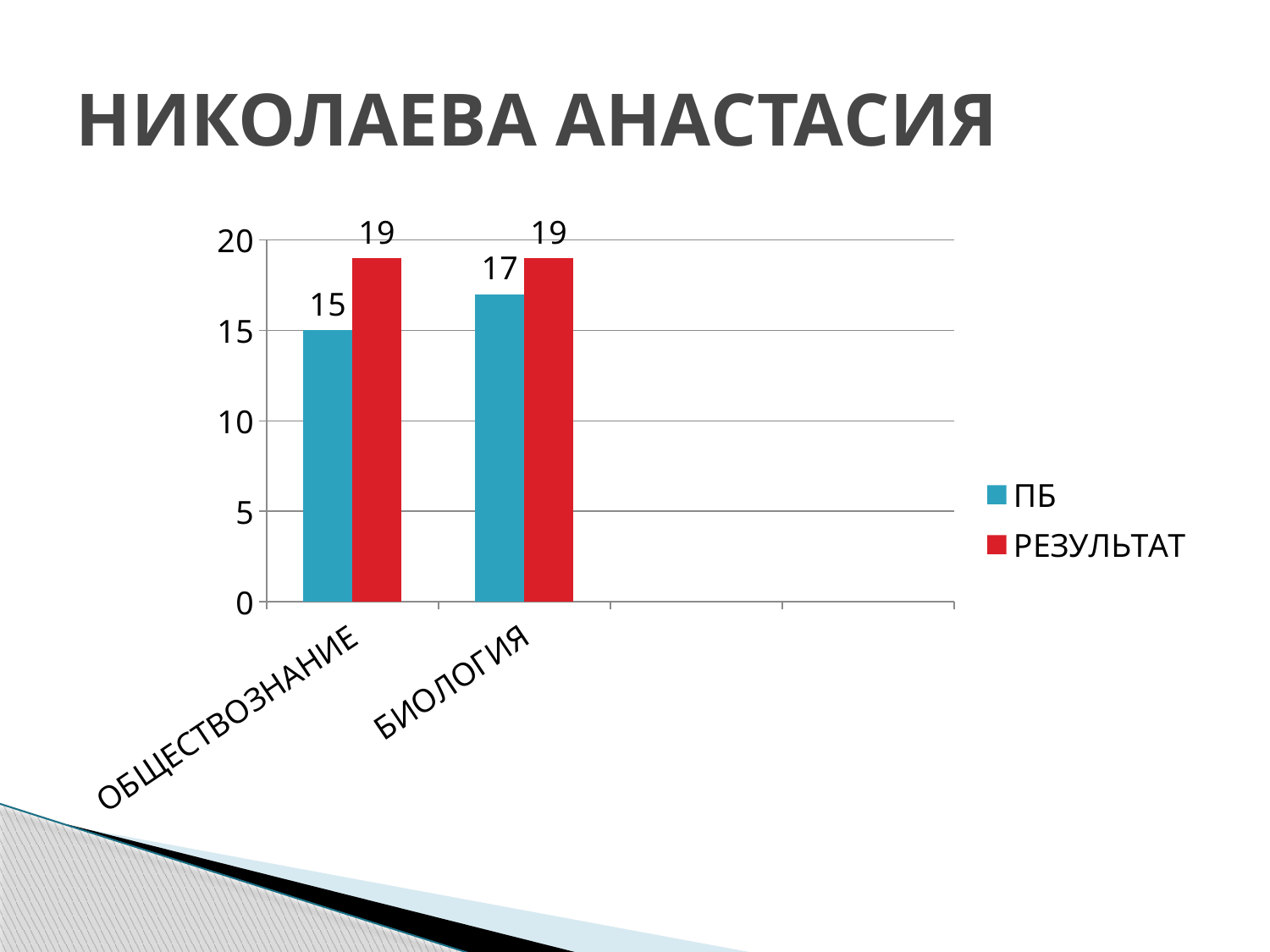
Which category has the lowest ПБ value? ОБЩЕСТВОЗНАНИЕ What is the difference between the РЕЗУЛЬТАТ and ПБ values for ОБЩЕСТВОЗНАНИЕ? 4 What colour are the РЕЗУЛЬТАТ bars? Red What is the ПБ value for БИОЛОГИЯ? 17 What is the difference between the РЕЗУЛЬТАТ and ПБ values for БИОЛОГИЯ? 2 What is the ПБ value for ОБЩЕСТВОЗНАНИЕ? 15 What kind of chart is shown on the slide? Bar chart Which is larger for БИОЛОГИЯ, the ПБ value or the РЕЗУЛЬТАТ value? РЕЗУЛЬТАТ What is the РЕЗУЛЬТАТ value for ОБЩЕСТВОЗНАНИЕ? 19 How many series does the legend list? 2 How many categories are shown on the x axis? 2 What is the РЕЗУЛЬТАТ value for БИОЛОГИЯ? 19